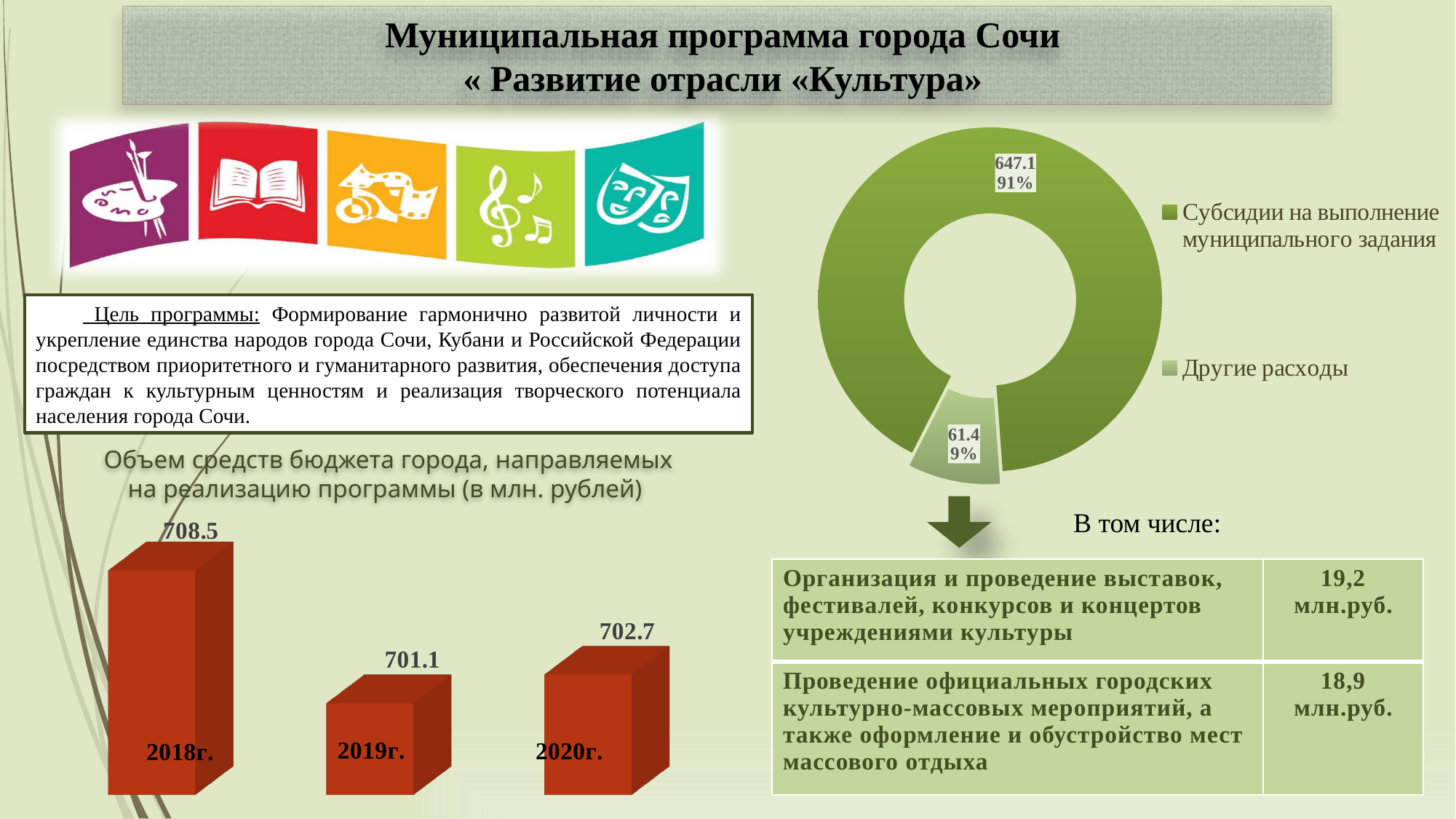
In the bar chart 'Объем средств бюджета города, направляемых на реализацию программы', which year has the lowest value? 2019г. In the doughnut chart on the right, what is the value for 'Субсидии на выполнение муниципального задания'? 647.1 In the bar chart 'Объем средств бюджета города, направляемых на реализацию программы', what is the value for 2018г.? 708.5 In the bar chart 'Объем средств бюджета города, направляемых на реализацию программы', what is the value for 2019г.? 701.1 In the bar chart 'Объем средств бюджета города, направляемых на реализацию программы', how many years are shown? 3 In the bar chart 'Объем средств бюджета города, направляемых на реализацию программы', what is the difference between the values for 2018г. and 2020г.? 5.8 What kind of chart is the one titled 'Объем средств бюджета города, направляемых на реализацию программы'? Bar chart In the bar chart 'Объем средств бюджета города, направляемых на реализацию программы', which year has the highest value? 2018г. In the bar chart 'Объем средств бюджета города, направляемых на реализацию программы', what is the value for 2020г.? 702.7 In the doughnut chart on the right, what share does 'Другие расходы' represent? 9% In the doughnut chart on the right, how many entries does the legend list? 2 In the doughnut chart on the right, which is larger: 'Субсидии на выполнение муниципального задания' or 'Другие расходы'? Субсидии на выполнение муниципального задания